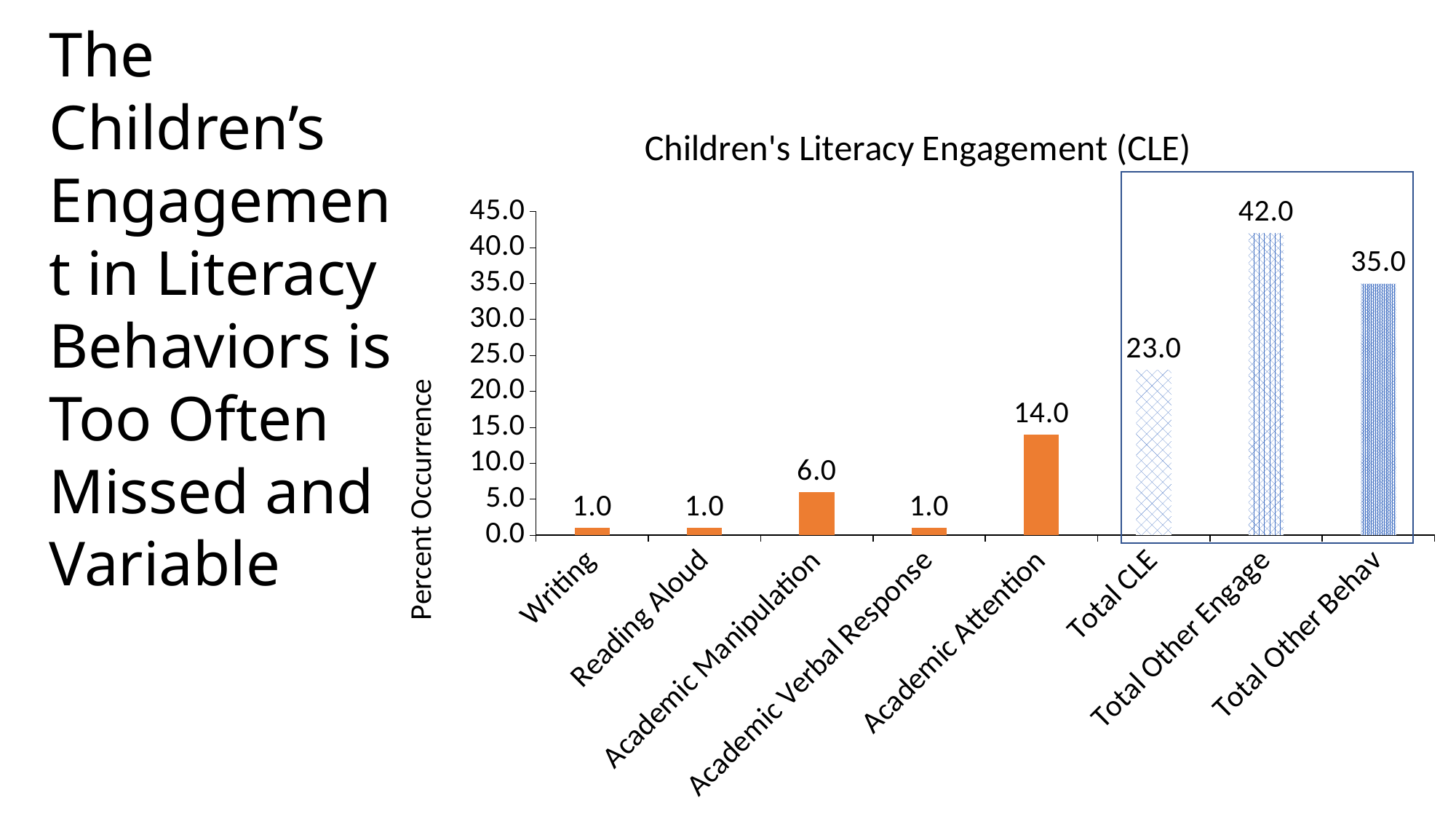
What is the value for Academic Manipulation? 6.0 How many categories are shown on the x axis? 8 What is the difference between Academic Attention and Academic Manipulation? 8.0 Is the value for Total Other Engage greater or less than 40.0? greater What is the title of the chart? Children's Literacy Engagement (CLE) What is the value for Academic Attention? 14.0 Which is larger, Total CLE or Total Other Behav? Total Other Behav What kind of chart is shown? bar chart Which category has the highest value? Total Other Engage What is the value for Total CLE? 23.0 What is the value for Total Other Engage? 42.0 What is the difference between Total Other Engage and Total Other Behav? 7.0